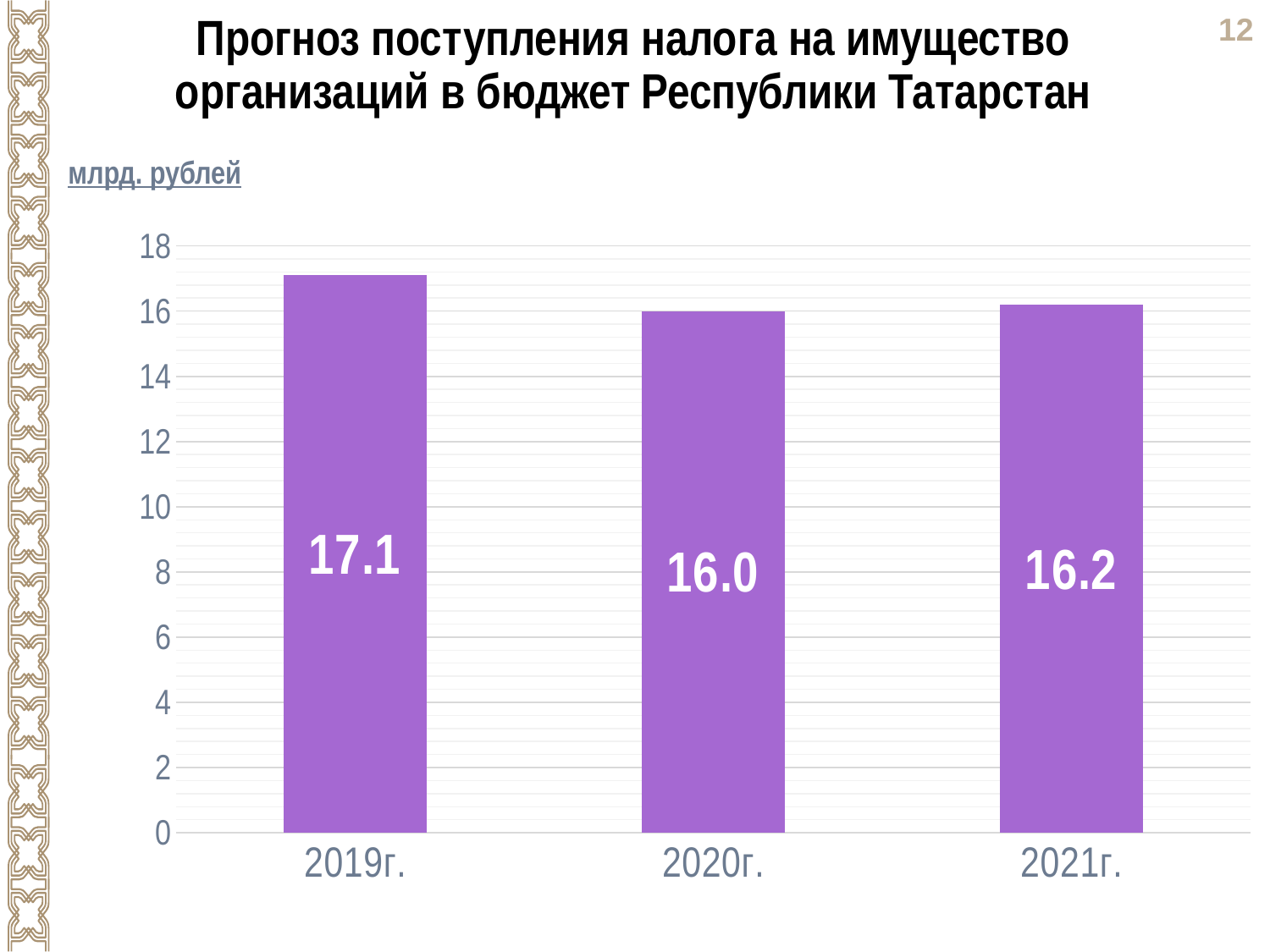
What kind of chart is shown on the slide? bar chart What is the forecast value for 2020г.? 16.0 Which is larger, the value for 2019г. or the value for 2021г.? 2019г. What is the difference between the values for 2019г. and 2020г.? 1.1 Which year has the highest forecast value? 2019г. What is the forecast value for 2021г.? 16.2 What is the forecast value for 2019г.? 17.1 What unit of measurement is indicated for the chart? млрд. рублей What is the difference between the values for 2021г. and 2020г.? 0.2 Is the value for 2020г. greater or less than 18? less Which year has the lowest forecast value? 2020г. How many years are shown on the chart? 3